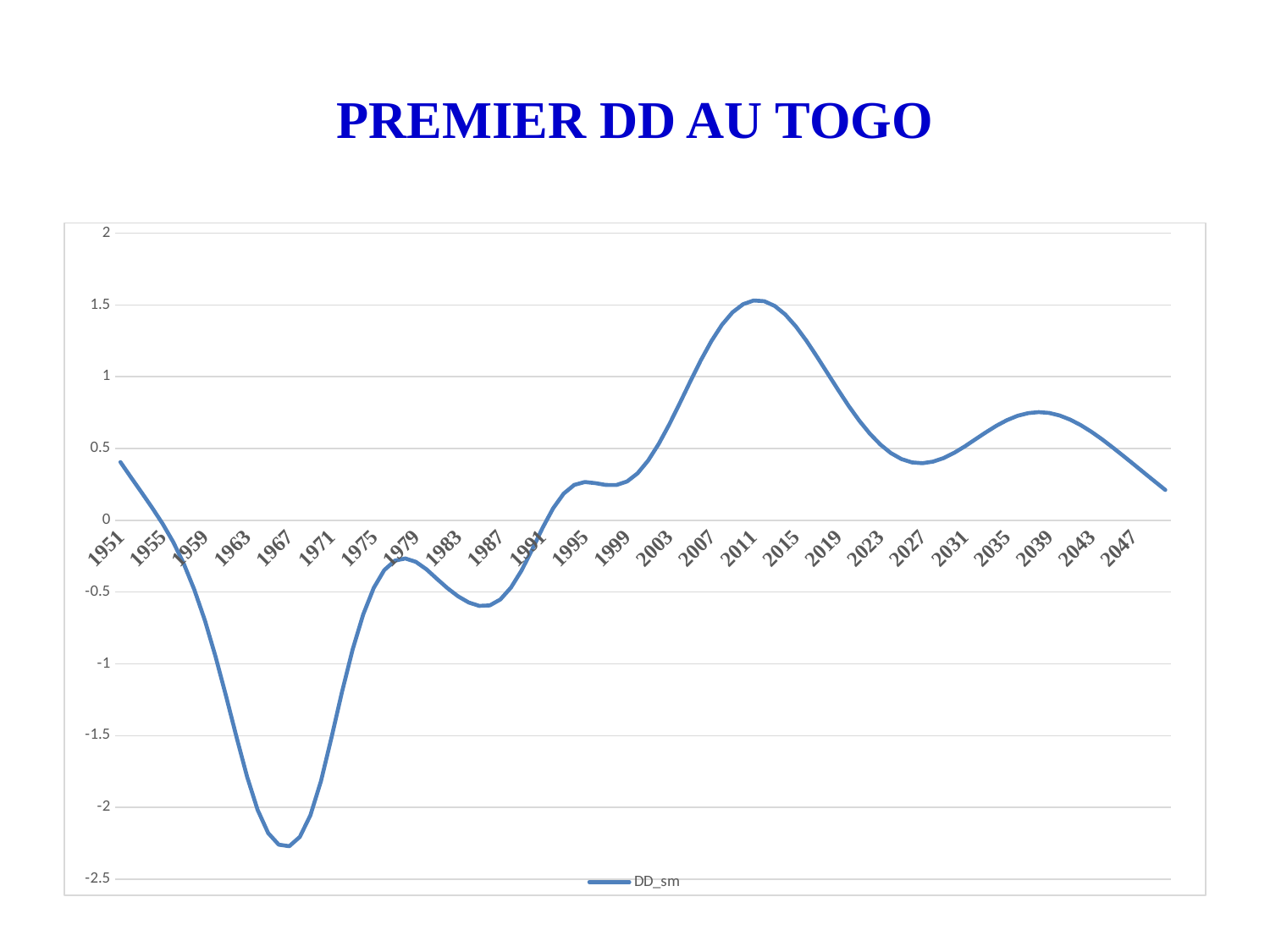
Which is larger, the value of DD_sm in 2011 or in 2039? 2011 Is the value of DD_sm in 2039 greater or less than 0.5? greater What is the title of the slide's chart? PREMIER DD AU TOGO What kind of chart is shown on the slide? line chart What is the name of the series shown in the legend? DD_sm Is the value of DD_sm in 2011 greater or less than 1? greater How many series does the legend list? 1 Is the value of DD_sm in 1951 greater or less than 0? greater Does the DD_sm line rise or fall between 1951 and 1967? fall How many year labels are shown on the x axis? 25